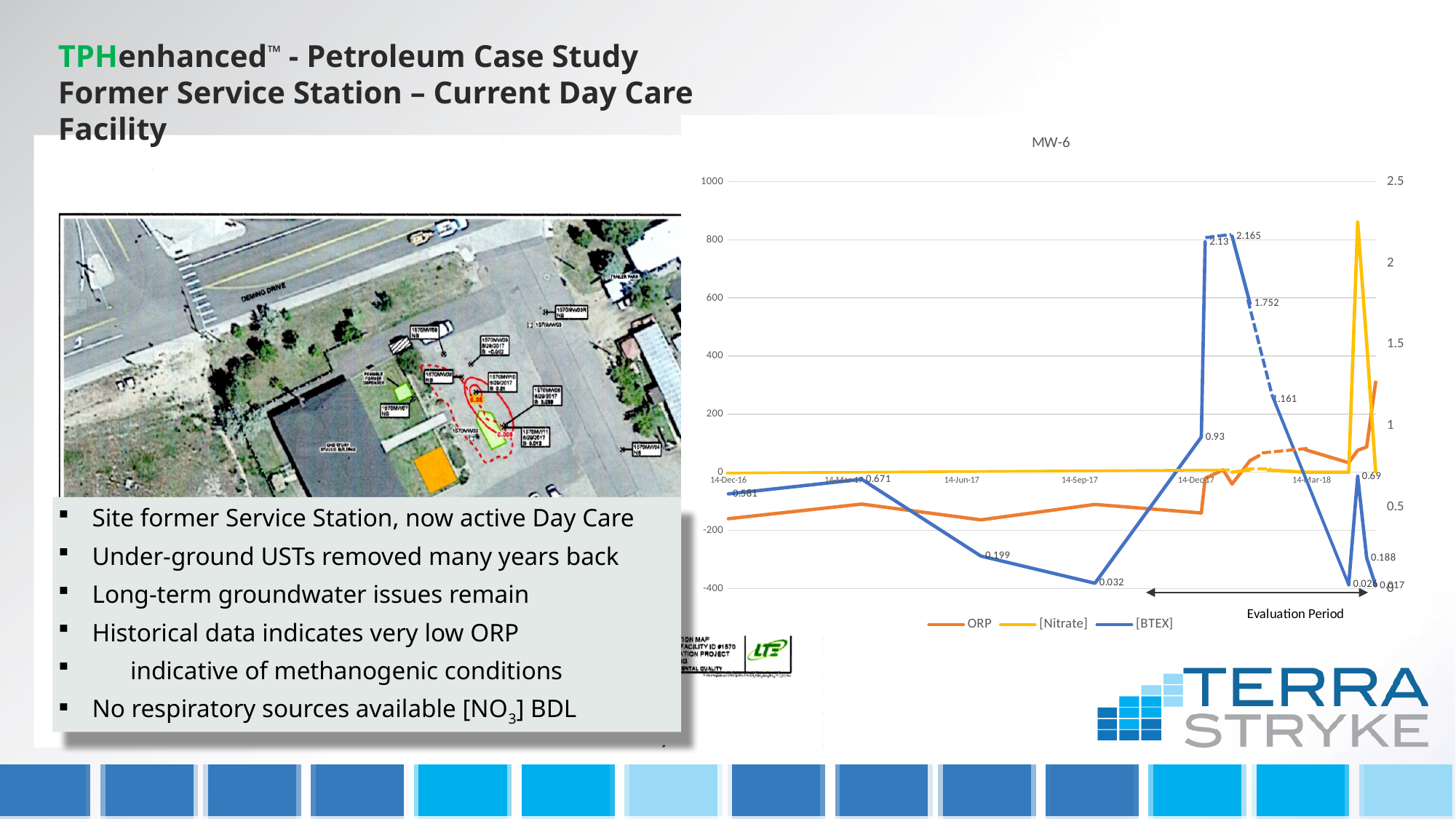
What kind of chart is shown on the slide? line chart Is the ORP value at 14-Dec-16 greater or less than 0 on the left axis? less Does the [BTEX] series rise or fall between 14-Mar-17 and 14-Sep-17? fall What is the highest labelled [BTEX] value on the chart? 2.165 What is the lowest labelled [BTEX] value on the chart? 0.017 What is the difference between the labelled [BTEX] values 2.165 and 2.13? 0.035 What is the labelled [BTEX] value at 14-Dec-16? 0.581 Which is larger, the labelled [BTEX] value 0.93 or the labelled [BTEX] value 0.199? 0.93 How many series does the chart legend list? 3 Which series are listed in the chart legend? ORP, [Nitrate], [BTEX] What is the title of the chart? MW-6 What is the labelled [BTEX] value at 14-Sep-17? 0.032